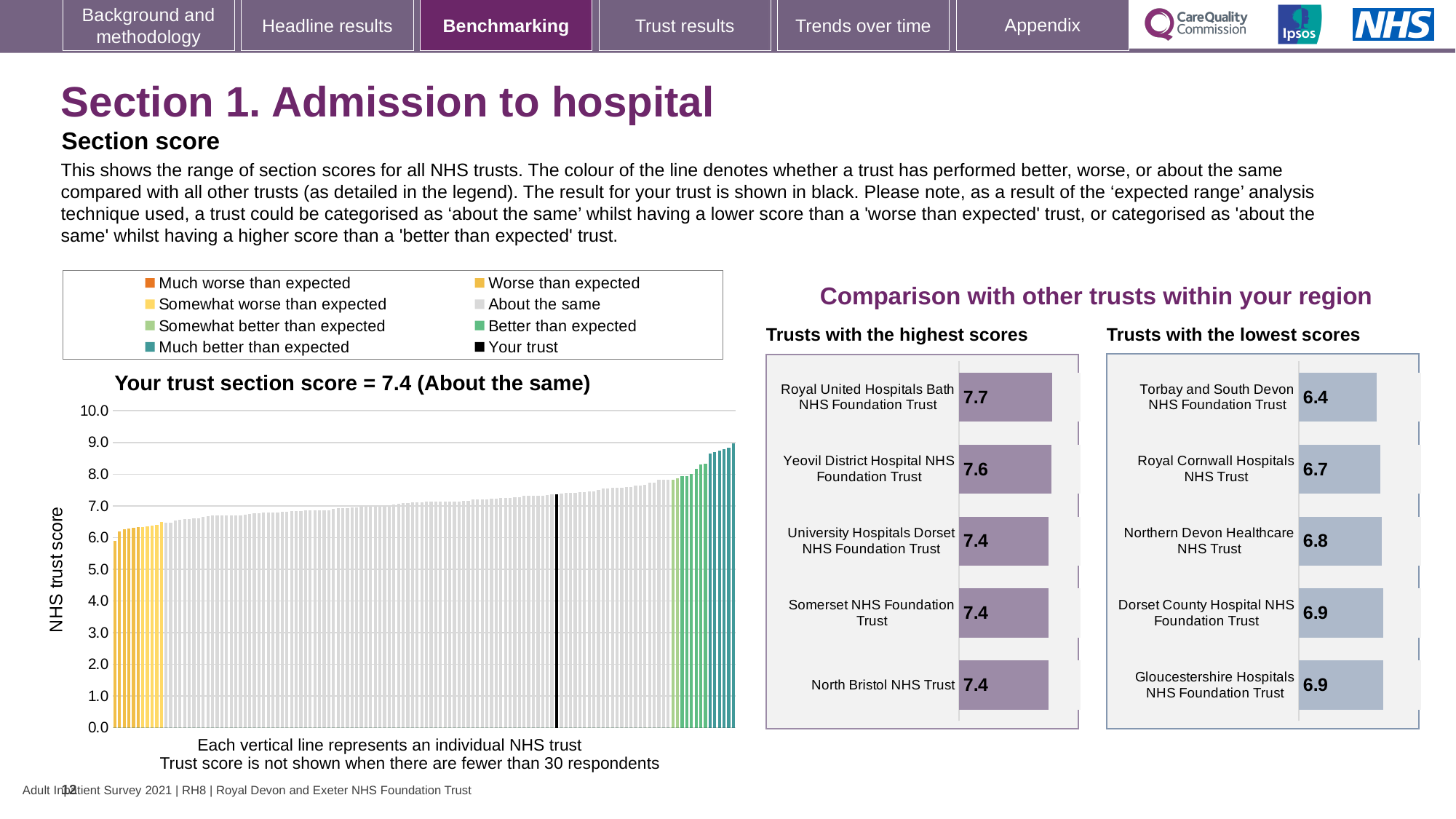
What kind of chart is the 'Your trust section score' chart? Bar chart In the 'Trusts with the highest scores' chart, what is the score for Royal United Hospitals Bath NHS Foundation Trust? 7.7 In the 'Trusts with the lowest scores' chart, which trust has the lowest score? Torbay and South Devon NHS Foundation Trust In the 'Trusts with the highest scores' chart, which trust has the highest score? Royal United Hospitals Bath NHS Foundation Trust In the 'Trusts with the lowest scores' chart, what is the score for Northern Devon Healthcare NHS Trust? 6.8 In the 'Trusts with the highest scores' chart, what is the score for Yeovil District Hospital NHS Foundation Trust? 7.6 According to the title of the 'Your trust section score' chart, what is your trust's section score? 7.4 (About the same) In the 'Trusts with the lowest scores' chart, which has the larger score: Royal Cornwall Hospitals NHS Trust or Dorset County Hospital NHS Foundation Trust? Dorset County Hospital NHS Foundation Trust In the 'Your trust section score' chart, do the trust scores rise or fall from left to right along the x axis? Rise How many trusts are listed in the 'Trusts with the highest scores' chart? 5 In the 'Trusts with the lowest scores' chart, what is the score for Torbay and South Devon NHS Foundation Trust? 6.4 What is the difference between the score for Royal United Hospitals Bath NHS Foundation Trust in the highest scores chart and the score for Torbay and South Devon NHS Foundation Trust in the lowest scores chart? 1.3